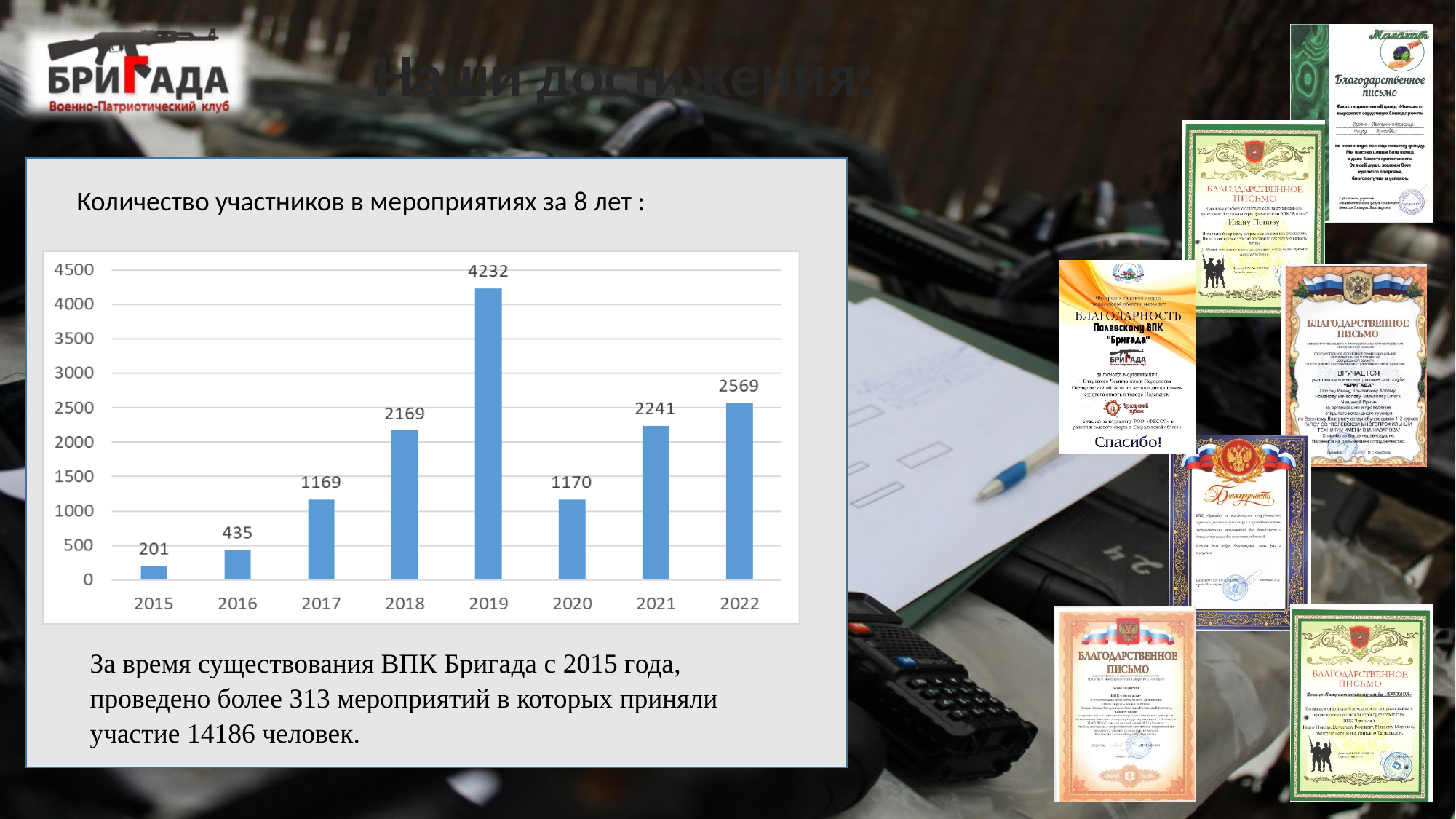
Which year has the highest number of participants? 2019 What is the difference between the values for 2022 and 2021? 328 What is the value for 2022? 2569 Which is larger, the value for 2018 or the value for 2020? 2018 What is the difference between the values for 2019 and 2020? 3062 What type of chart is shown on the slide? bar chart How many participants are shown for 2019? 4232 What is the title written above the chart? Количество участников в мероприятиях за 8 лет : How many years are shown on the x axis of the chart? 8 What is the value for 2015? 201 Is the value for 2017 greater or less than 1000? greater Which year has the lowest number of participants? 2015